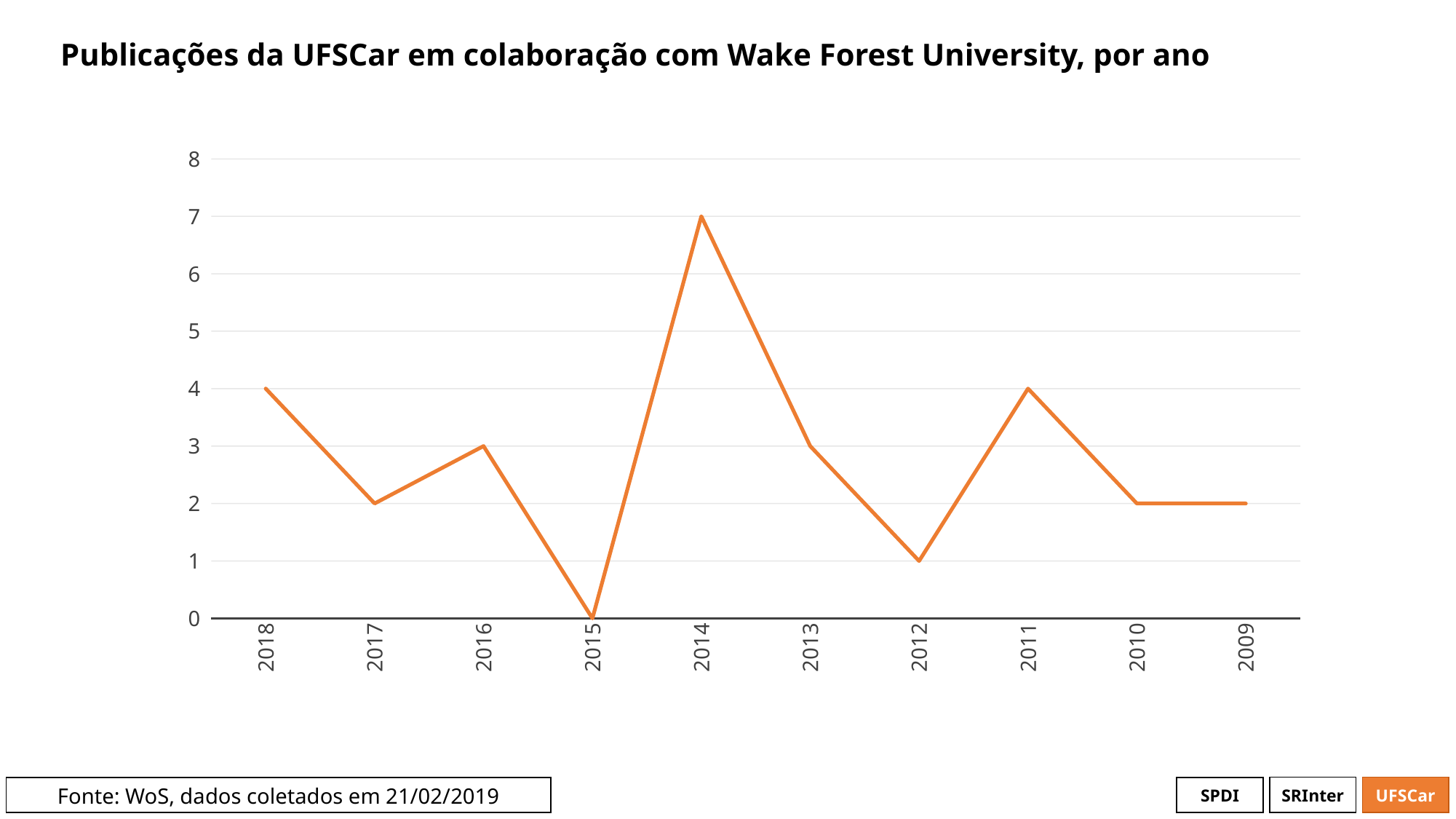
What is the title of the chart? Publicações da UFSCar em colaboração com Wake Forest University, por ano How many years are plotted on the x axis? 10 What is the difference between the values for 2014 and 2013? 4 Which year has the lowest value? 2015 Which is larger, the value for 2011 or the value for 2010? 2011 What is the value for 2018? 4 What is the value for 2014? 7 What kind of chart is shown on the slide? line chart Which year has the highest value? 2014 What is the value for 2012? 1 What is the value for 2015? 0 Do the values rise or fall from 2015 to 2014 along the x axis? rise